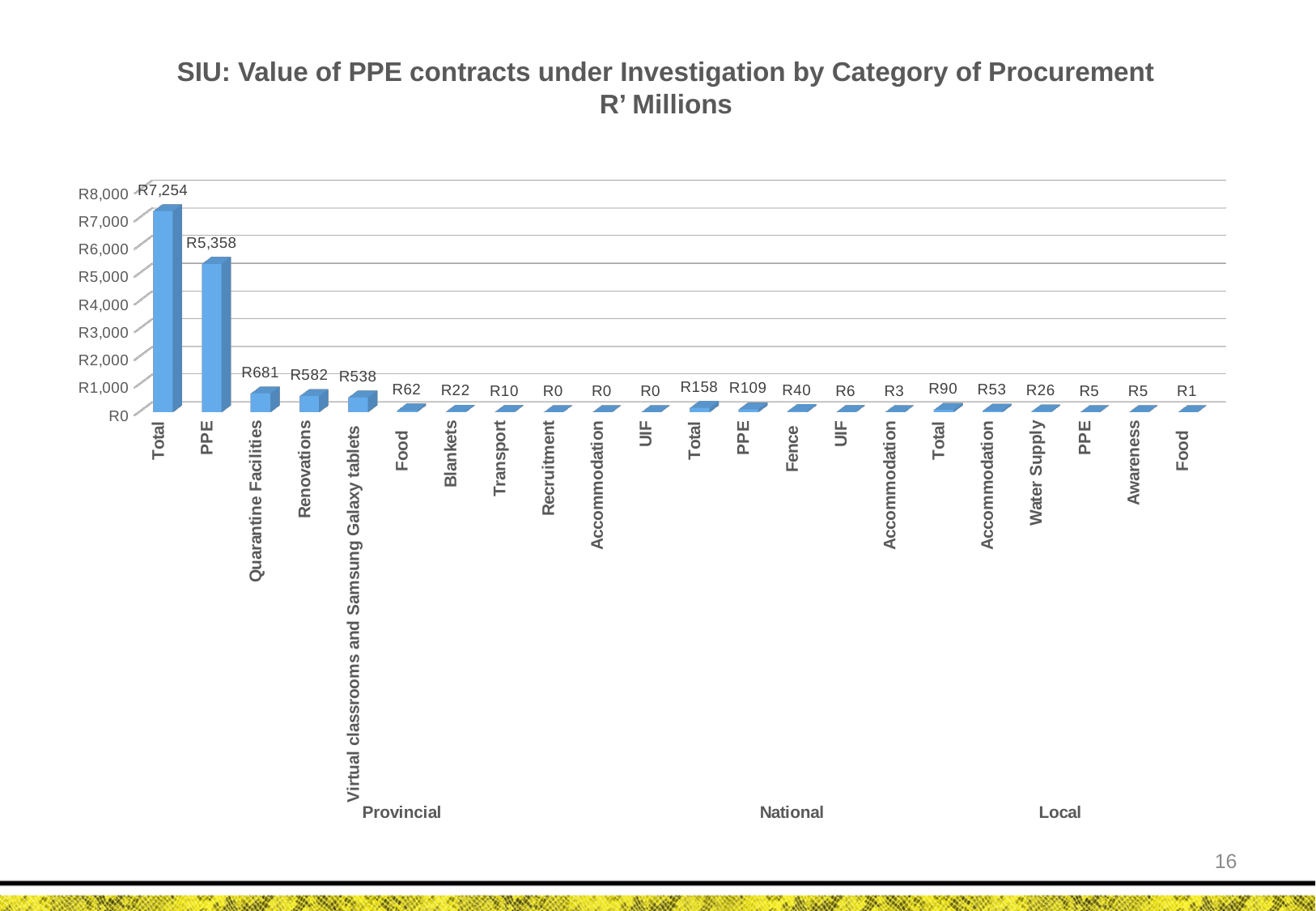
Which is larger: PPE in the National group or Accommodation in the Local group? PPE in the National group What are the three procurement groups labelled along the bottom of the chart? Provincial, National, Local What is the value for Fence in the National group? R40 What is the value for Quarantine Facilities in the Provincial group? R681 How many bars (categories) are plotted on the chart? 22 What is the value for Water Supply in the Local group? R26 What is the difference between the Provincial Total and the Provincial PPE value? R1,896 Which category has the highest value on the chart? Total (Provincial) What kind of chart is shown on the slide? Bar chart What is the difference between Renovations and Virtual classrooms and Samsung Galaxy tablets in the Provincial group? R44 What is the value for PPE in the Provincial group? R5,358 What is the value for Total in the National group? R158